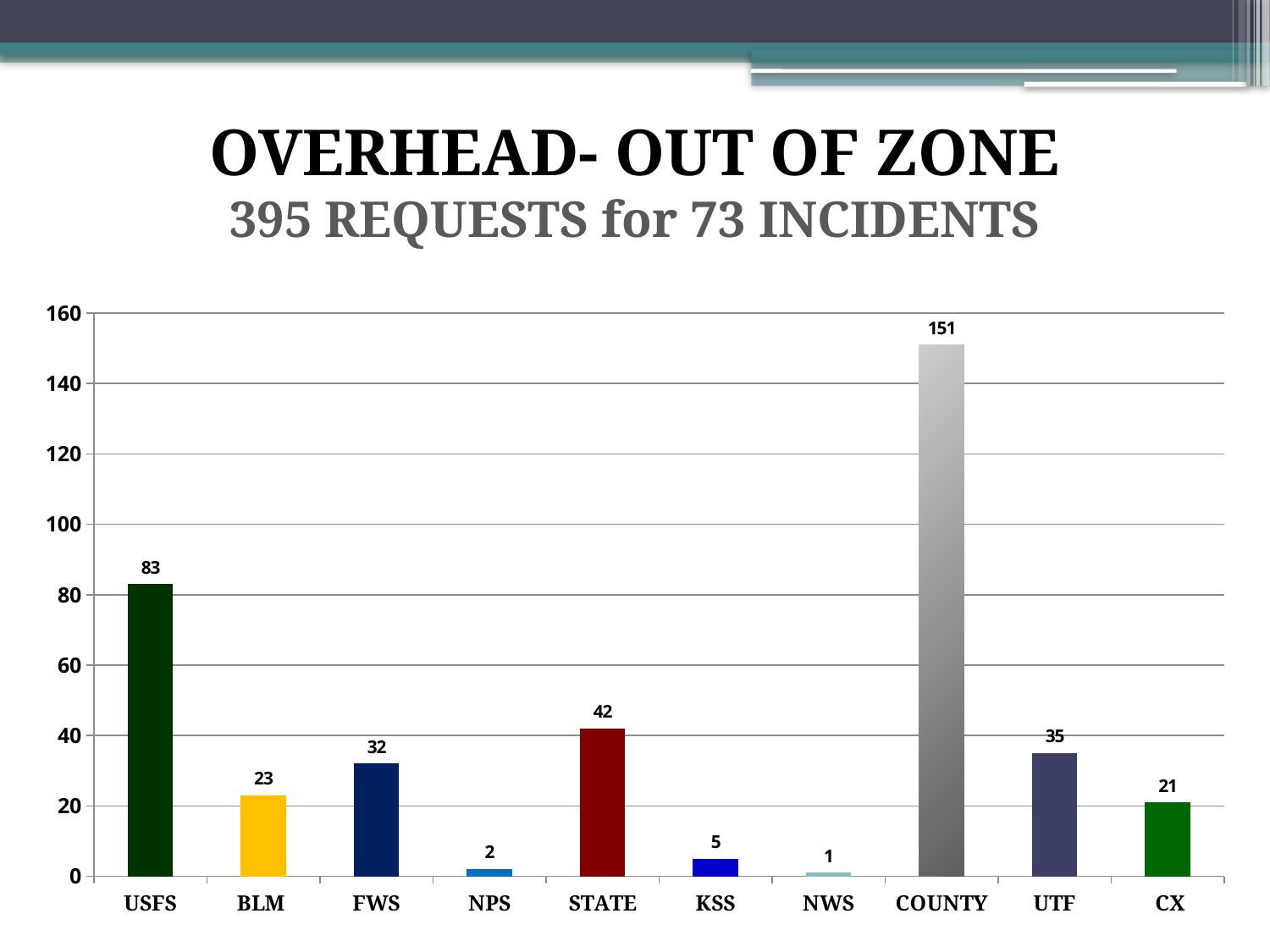
Which category has the lowest value? NWS What is the difference between the values for BLM and CX? 2 What is the value for USFS? 83 Is the value for COUNTY greater or less than 140? greater What is the title of the slide? OVERHEAD- OUT OF ZONE Which is larger, the value for FWS or the value for UTF? UTF What kind of chart is shown on the slide? bar chart What is the value for STATE? 42 How many categories are shown on the x axis? 10 What is the difference between the values for COUNTY and USFS? 68 Which category has the highest value? COUNTY What is the value for COUNTY? 151